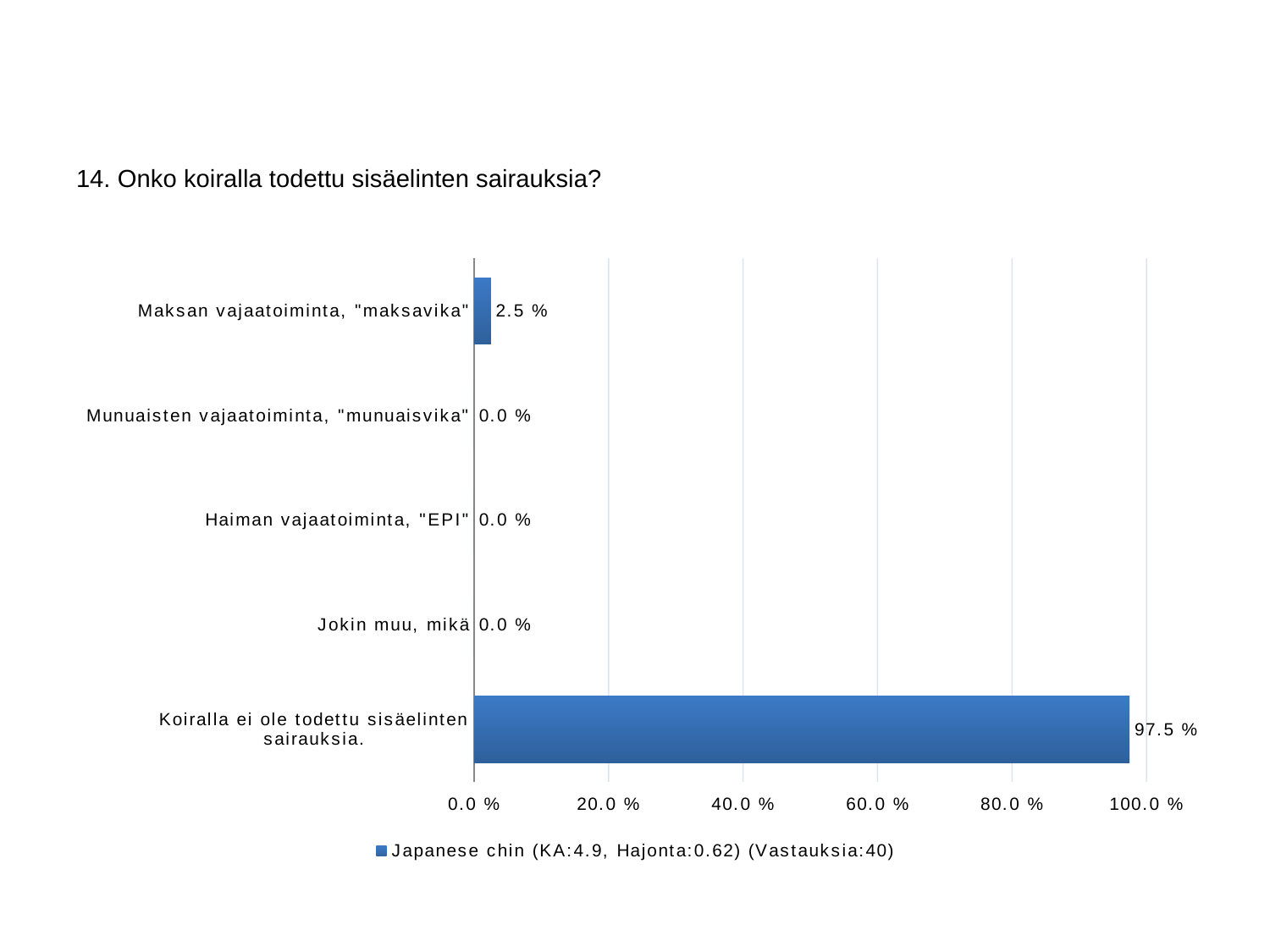
Is the value for "Koiralla ei ole todettu sisäelinten sairauksia." greater or less than 80.0 %? greater What is the value for "Maksan vajaatoiminta, "maksavika""? 2.5 % Which category has the highest value? Koiralla ei ole todettu sisäelinten sairauksia. What kind of chart is shown on the slide? bar chart How many series does the legend list? 1 How many categories are shown on the chart? 5 Which is larger: the value for "Maksan vajaatoiminta, "maksavika"" or for "Munuaisten vajaatoiminta, "munuaisvika""? Maksan vajaatoiminta, "maksavika" What is the value for "Haiman vajaatoiminta, "EPI""? 0.0 % What is the difference between the values for "Koiralla ei ole todettu sisäelinten sairauksia." and "Maksan vajaatoiminta, "maksavika""? 95.0 % How many responses (Vastauksia) does the legend entry report? 40 What is the value for "Koiralla ei ole todettu sisäelinten sairauksia."? 97.5 % What is the title of the chart? 14. Onko koiralla todettu sisäelinten sairauksia?